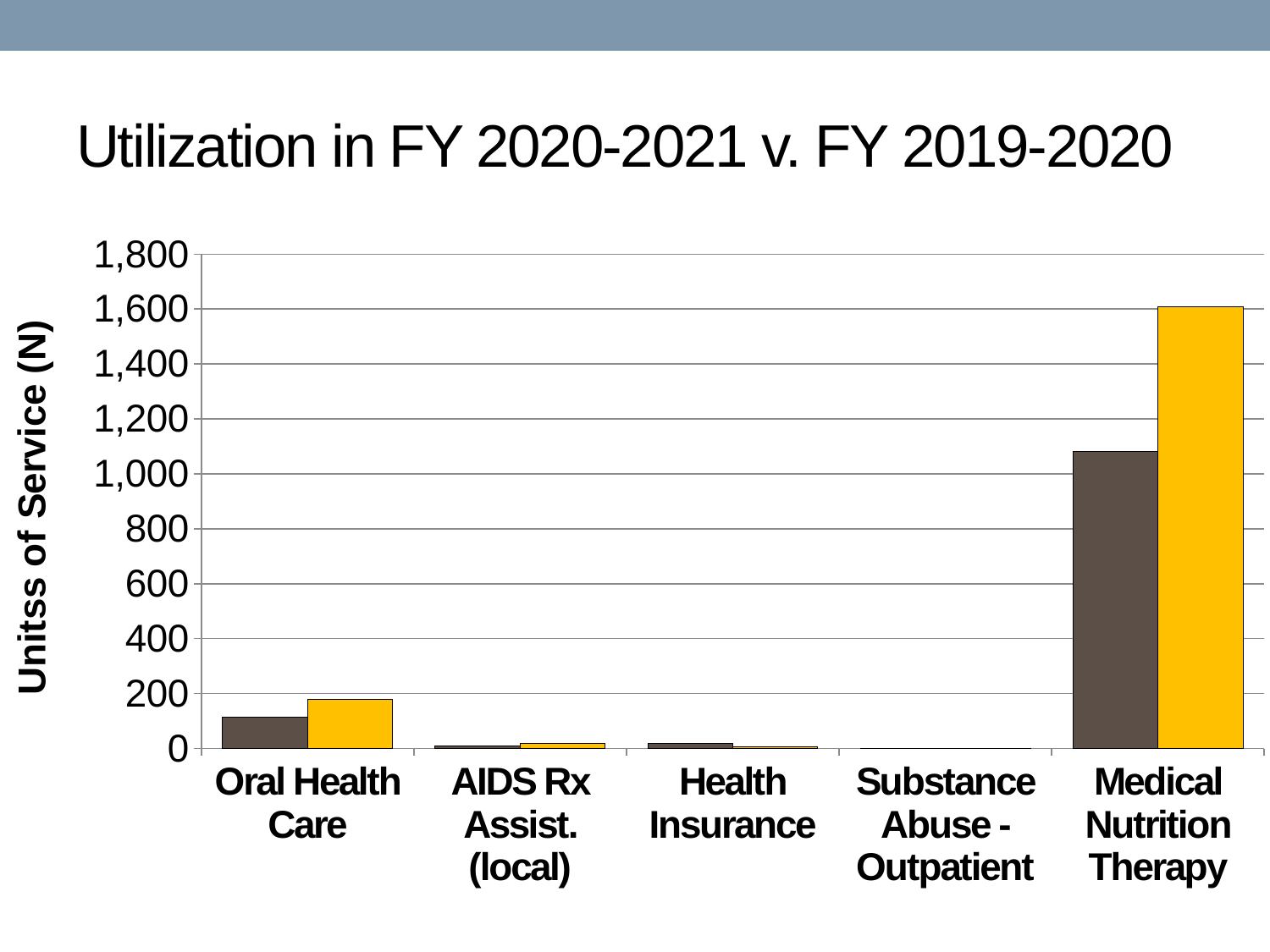
Is the yellow bar for Oral Health Care greater or less than 200? less Which category has the lowest bars in the chart? Substance Abuse - Outpatient Is the yellow bar for Medical Nutrition Therapy greater or less than 1,400? greater Is the dark brown bar for Medical Nutrition Therapy greater or less than 800? greater What kind of chart is shown on the slide? bar chart What is the label on the vertical axis of the chart? Unitss of Service (N) For Medical Nutrition Therapy, which bar is taller, the dark brown bar or the yellow bar? the yellow bar For Oral Health Care, which bar is taller, the dark brown bar or the yellow bar? the yellow bar What is the title of the chart? Utilization in FY 2020-2021 v. FY 2019-2020 Which category has the tallest bar in the chart? Medical Nutrition Therapy How many service categories are shown on the x axis? 5